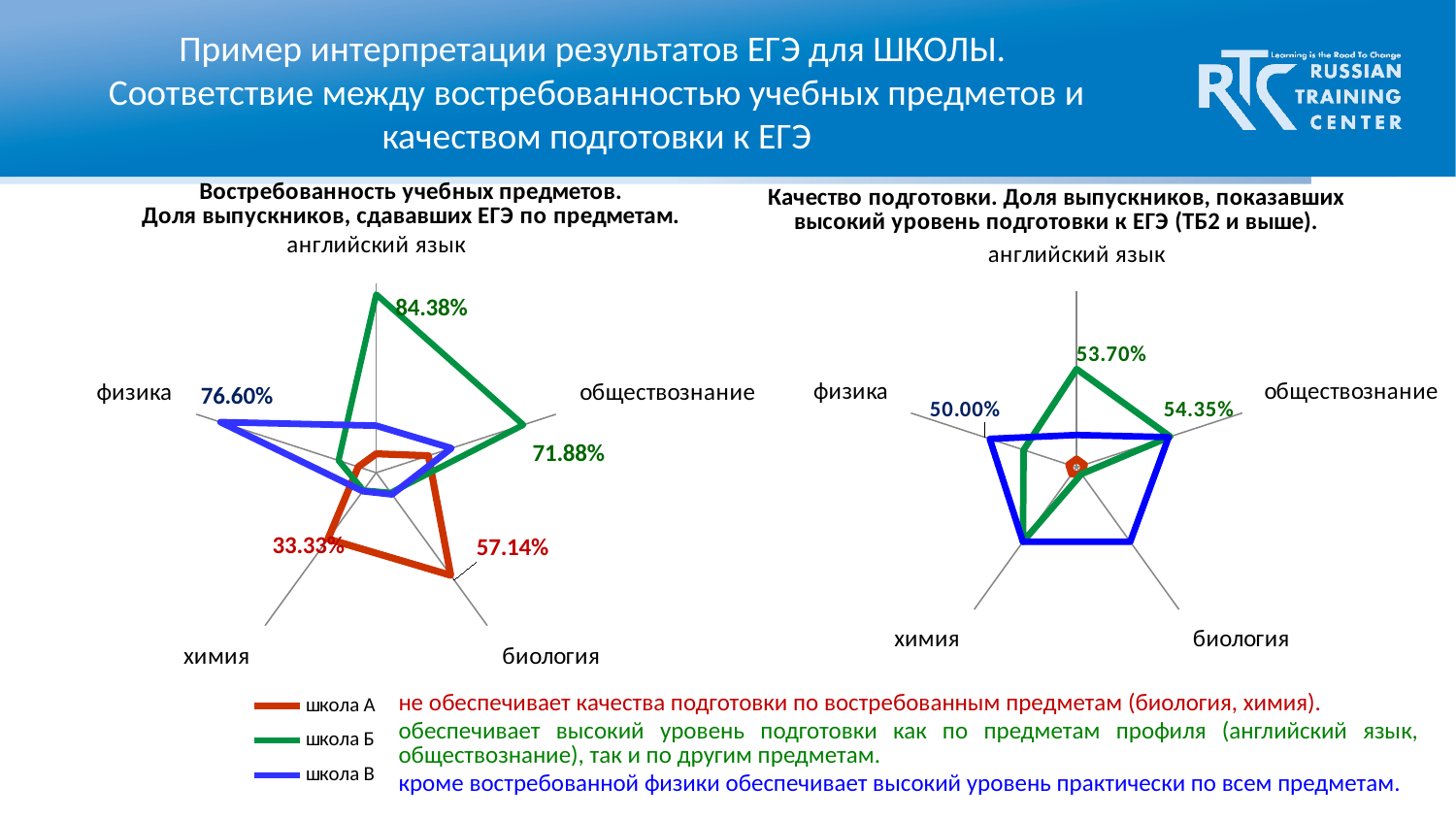
On the left chart (Востребованность учебных предметов), what value is labelled for школа А on химия? 33.33% On the left chart (Востребованность учебных предметов), what value is labelled for школа В on физика? 76.60% On the left chart (Востребованность учебных предметов), what value is labelled for школа Б on обществознание? 71.88% On the right chart (Качество подготовки), what value is labelled for школа Б on английский язык? 53.70% On the left chart (Востребованность учебных предметов), which is larger for школа А: the labelled value on биология or on химия? биология On the left chart (Востребованность учебных предметов), what value is labelled for школа Б on английский язык? 84.38% How many series does the legend list for the charts on the slide? 3 On the left chart (Востребованность учебных предметов), what value is labelled for школа А on биология? 57.14% On the left chart (Востребованность учебных предметов), what is the difference between the labelled values for школа Б on английский язык and on обществознание? 12.50% How many subject categories (axes) does the left chart (Востребованность учебных предметов) have? 5 What kind of chart is the right chart (Качество подготовки)? radar chart On the right chart (Качество подготовки), what value is labelled for школа В on физика? 50.00%